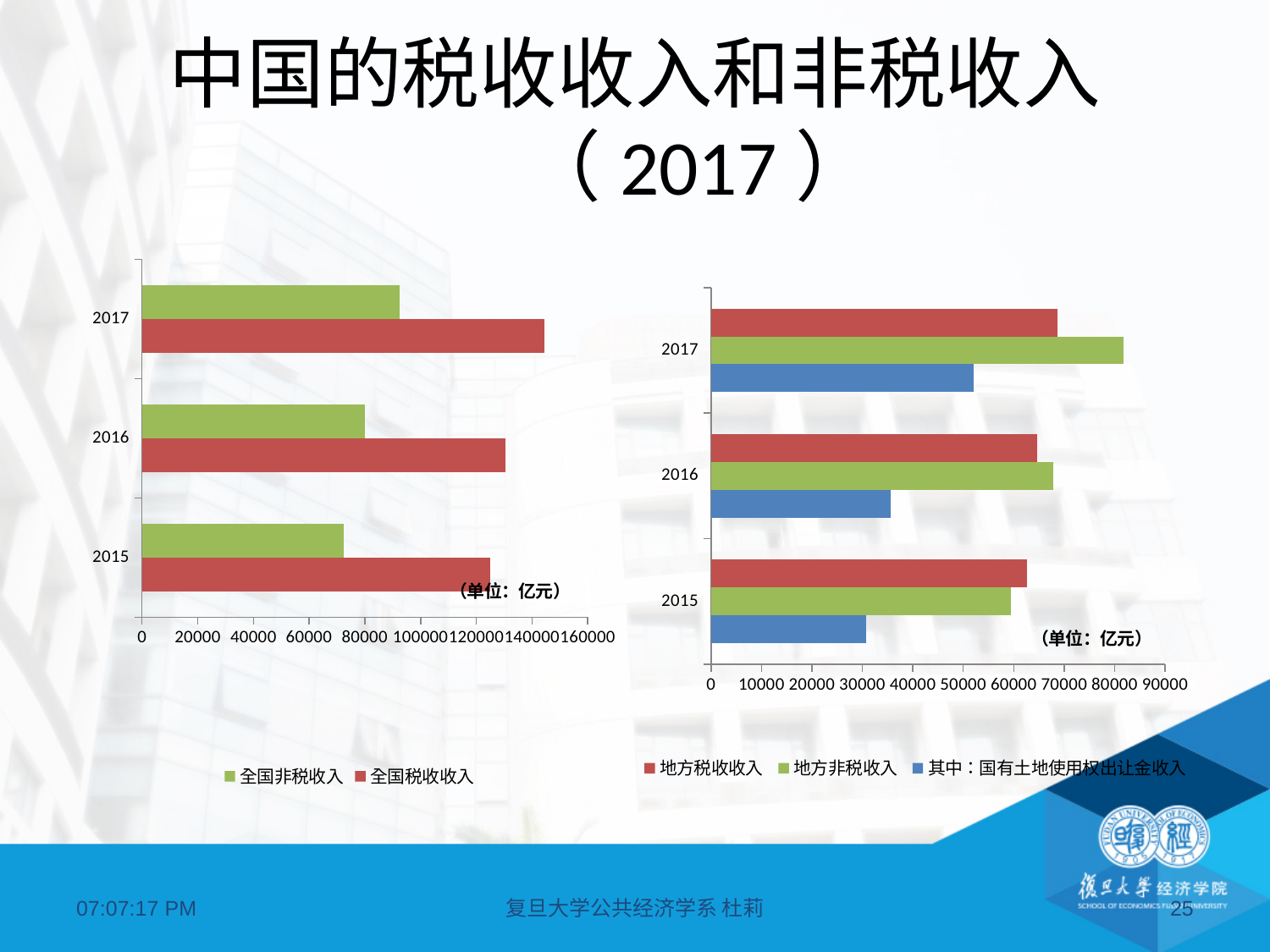
In the right chart, is the value of 地方非税收入 for 2017 greater or less than 70000? greater In the left chart, does 全国非税收入 rise or fall from 2015 to 2017? rise In the right chart, which year has the lowest 其中：国有土地使用权出让金收入? 2015 In the right chart, is the value of 其中：国有土地使用权出让金收入 for 2016 greater or less than 40000? less What unit is stated on the charts? 亿元 In the left chart, is the value of 全国税收收入 for 2017 greater or less than 140000? greater In the left chart, which year has the highest 全国税收收入? 2017 In the right chart, which is larger for 2017: 地方税收收入 or 地方非税收入? 地方非税收入 How many years are shown on the left chart? 3 How many series does the legend of the right chart list? 3 What kind of chart is the left chart on the slide? bar chart